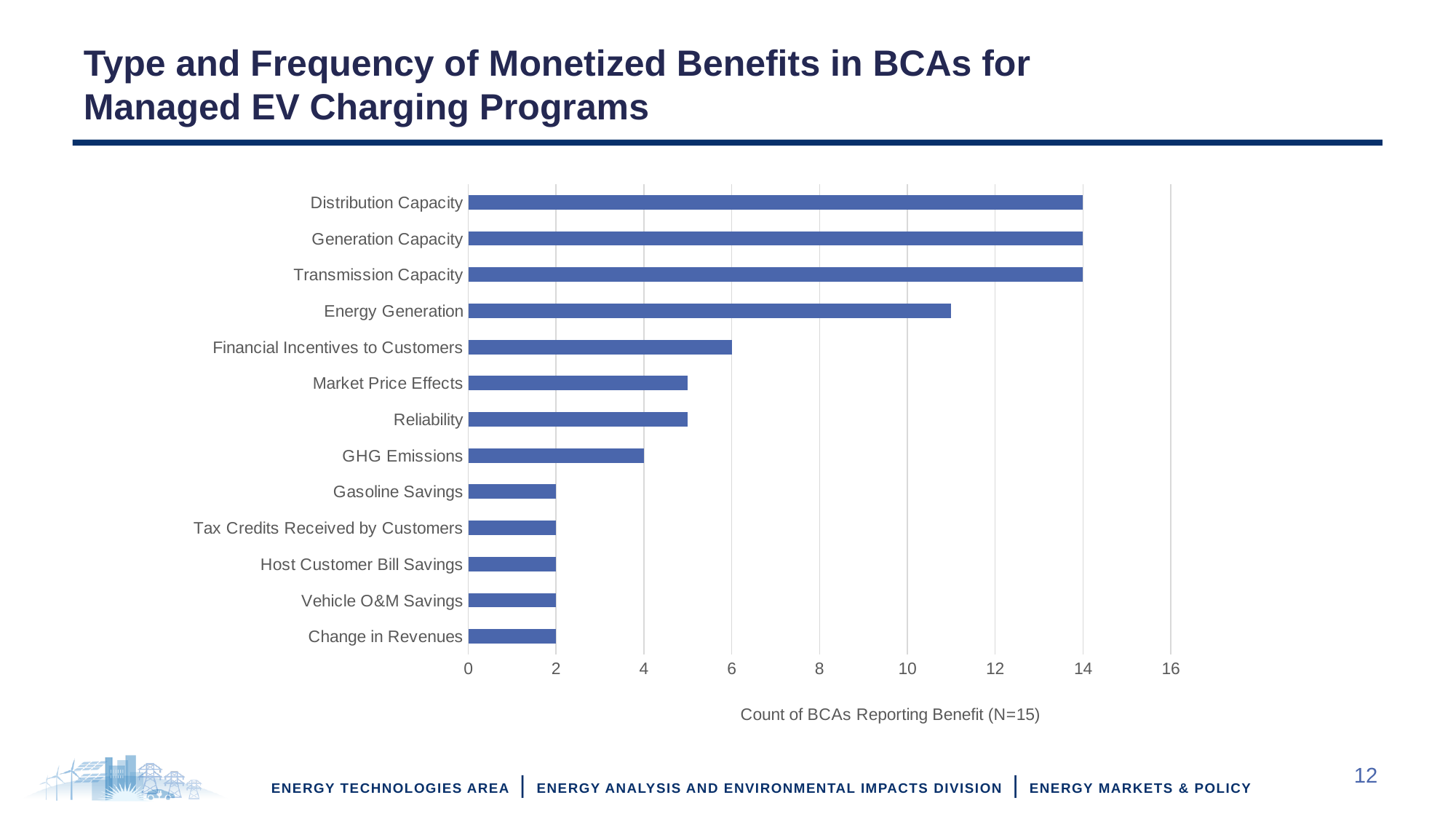
What is the count of BCAs reporting the Distribution Capacity benefit? 14 What is the count of BCAs reporting the Change in Revenues benefit? 2 What is the count of BCAs reporting the Financial Incentives to Customers benefit? 6 What is the label on the horizontal axis of the chart? Count of BCAs Reporting Benefit (N=15) What type of chart is shown on the slide? bar chart Is the value for Market Price Effects greater or less than 6? less Is the value for Energy Generation greater or less than 10? greater What is the count of BCAs reporting the GHG Emissions benefit? 4 Which has a higher value, Financial Incentives to Customers or GHG Emissions? Financial Incentives to Customers What is the difference between the values for Distribution Capacity and GHG Emissions? 10 Which has a higher value, Energy Generation or Reliability? Energy Generation How many benefit categories are plotted in the chart? 13